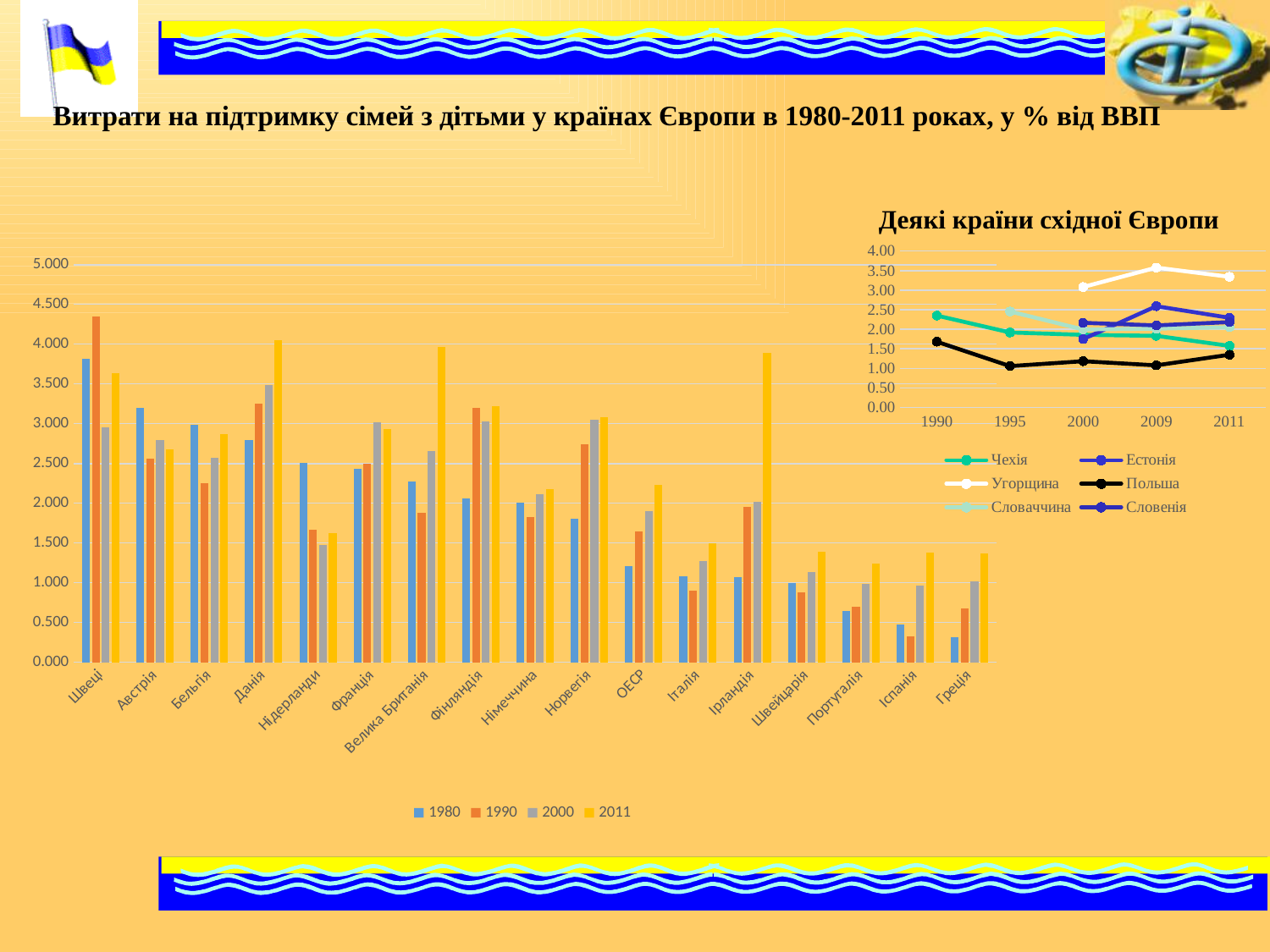
How many countries/categories are shown on the x axis of the bar chart on the left? 17 In the bar chart on the left, is the 1980 value for Греція greater or less than 0.500? less In the bar chart on the left, which is larger: the 1980 value for Швеці or the 1980 value for Австрія? Швеці In the bar chart on the left, is the 1990 value for Швеці greater or less than 4.000? greater How many series does the legend of the chart 'Деякі країни східної Європи' list? 6 What kind of chart is the large chart on the left of the slide? bar chart How many series does the legend of the bar chart on the left list? 4 In the chart 'Деякі країни східної Європи', does the value for Чехія rise or fall from 1990 to 2011? fall In the bar chart on the left, which country has the tallest bar overall? Швеці In the chart 'Деякі країни східної Європи', which country has the highest value in 2011? Угорщина How many years are shown on the x axis of the chart 'Деякі країни східної Європи'? 5 What kind of chart is the chart titled 'Деякі країни східної Європи'? line chart